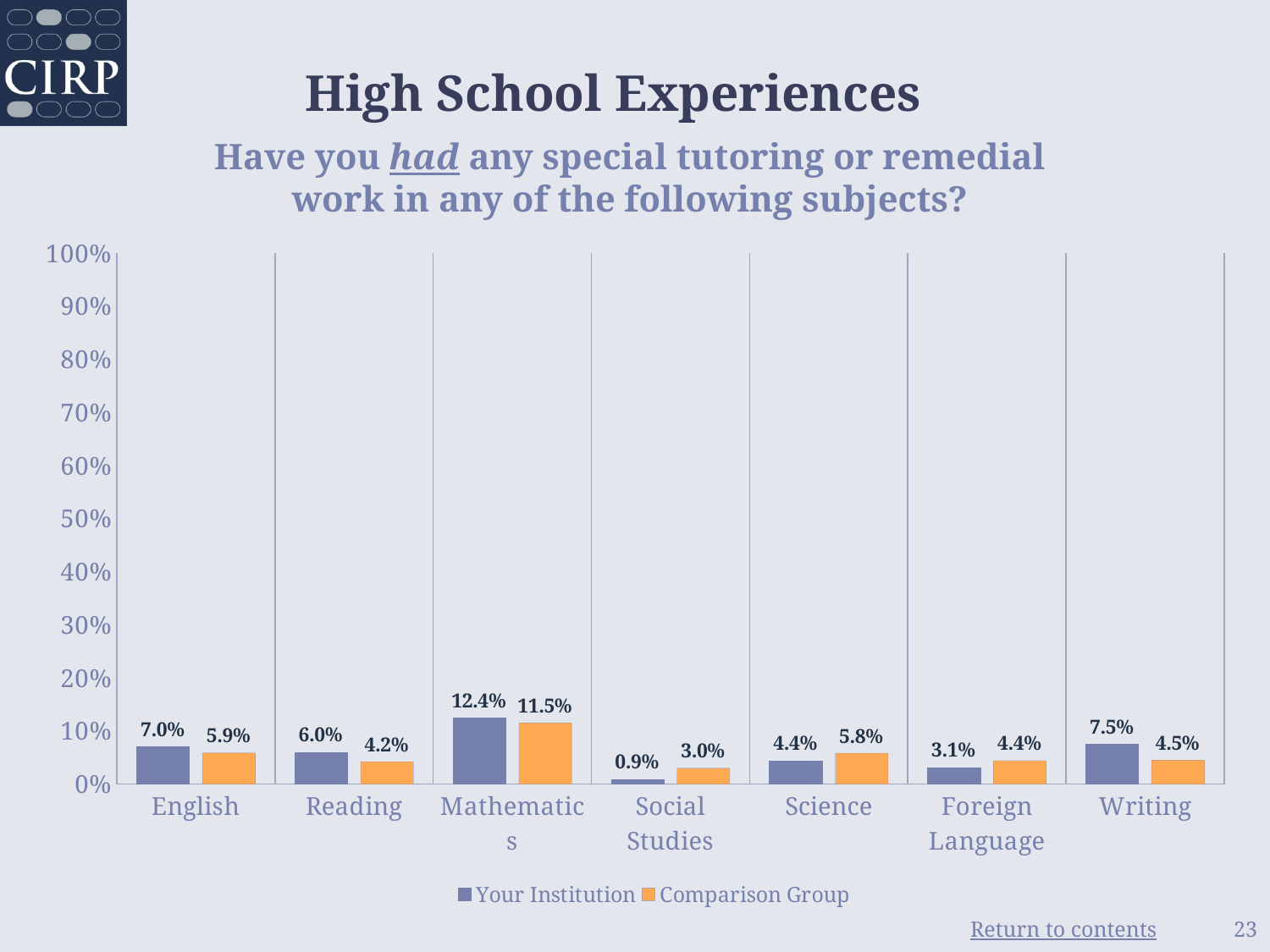
What is the value for Comparison Group in Social Studies? 3.0% What is the difference between Your Institution and Comparison Group in Reading? 1.8% How many series does the legend list? 2 What kind of chart is shown on the slide? Bar chart Which subject has the lowest value for Your Institution? Social Studies How many subjects are shown on the x axis? 7 What is the value for Your Institution in Mathematics? 12.4% What is the value for Your Institution in Foreign Language? 3.1% Which series is shown in orange? Comparison Group Which subject has the highest value for Your Institution? Mathematics Which is larger in Science, Your Institution or Comparison Group? Comparison Group Is the value for Your Institution in Mathematics greater or less than 10%? greater